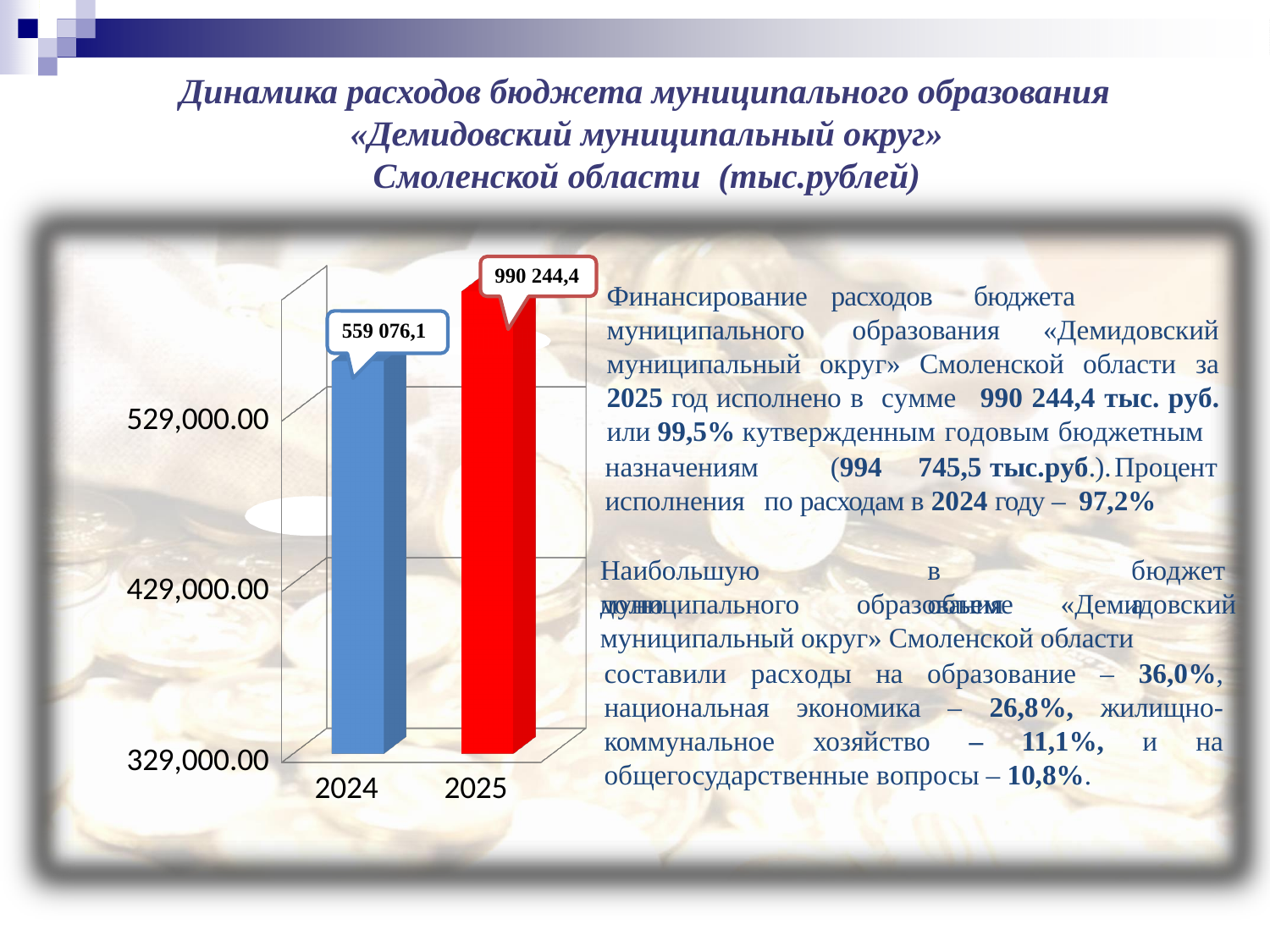
How many years (categories) are shown in the chart? 2 What kind of chart is shown on the slide? Bar chart What colour is the bar for 2025? Red What is the value shown for 2025? 990 244,4 Which year has the highest value in the chart? 2025 What colour is the bar for 2024? Blue What is the difference between the 2025 value and the 2024 value? 431 168,3 Which year has the lowest value in the chart? 2024 Do the values rise or fall from 2024 to 2025? Rise What is the value shown for 2024? 559 076,1 Which is larger, the value for 2024 or the value for 2025? 2025